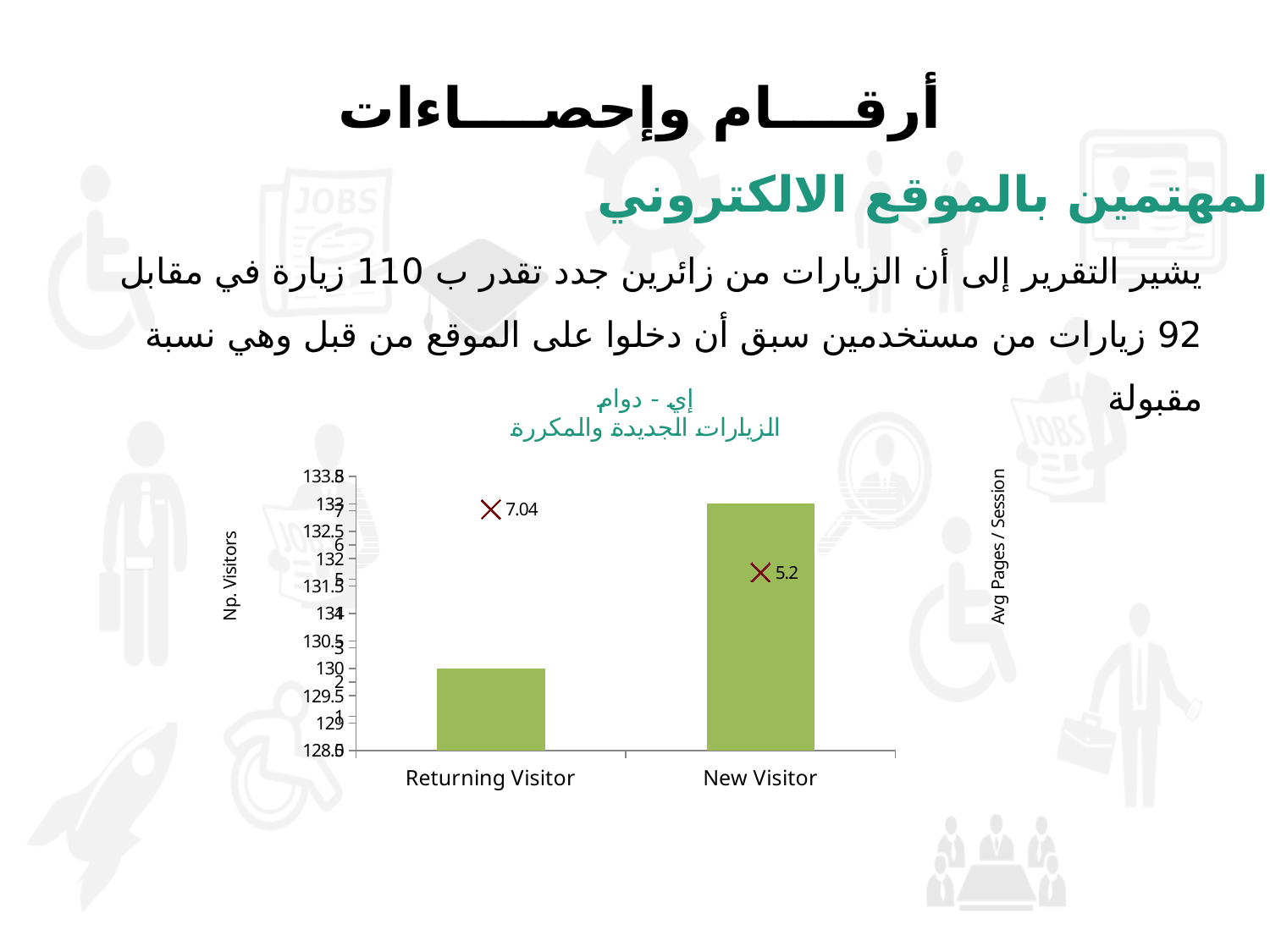
Which category has the higher Avg Pages / Session value, Returning Visitor or New Visitor? Returning Visitor Is the number of visitors bar for New Visitor greater or less than 132? greater What is the title of the right-hand vertical axis of the chart? Avg Pages / Session Do the Avg Pages / Session values rise or fall from Returning Visitor to New Visitor? fall What kind of chart is used to show the number of visitors? bar chart Is the number of visitors bar for Returning Visitor greater or less than 131? less How many categories are shown on the x axis of the chart? 2 Which category has the shorter bar for number of visitors? Returning Visitor What is the Avg Pages / Session value shown for Returning Visitor? 7.04 What is the difference between the Avg Pages / Session values for Returning Visitor and New Visitor? 1.84 What is the Avg Pages / Session value shown for New Visitor? 5.2 Which category has the taller bar for number of visitors? New Visitor